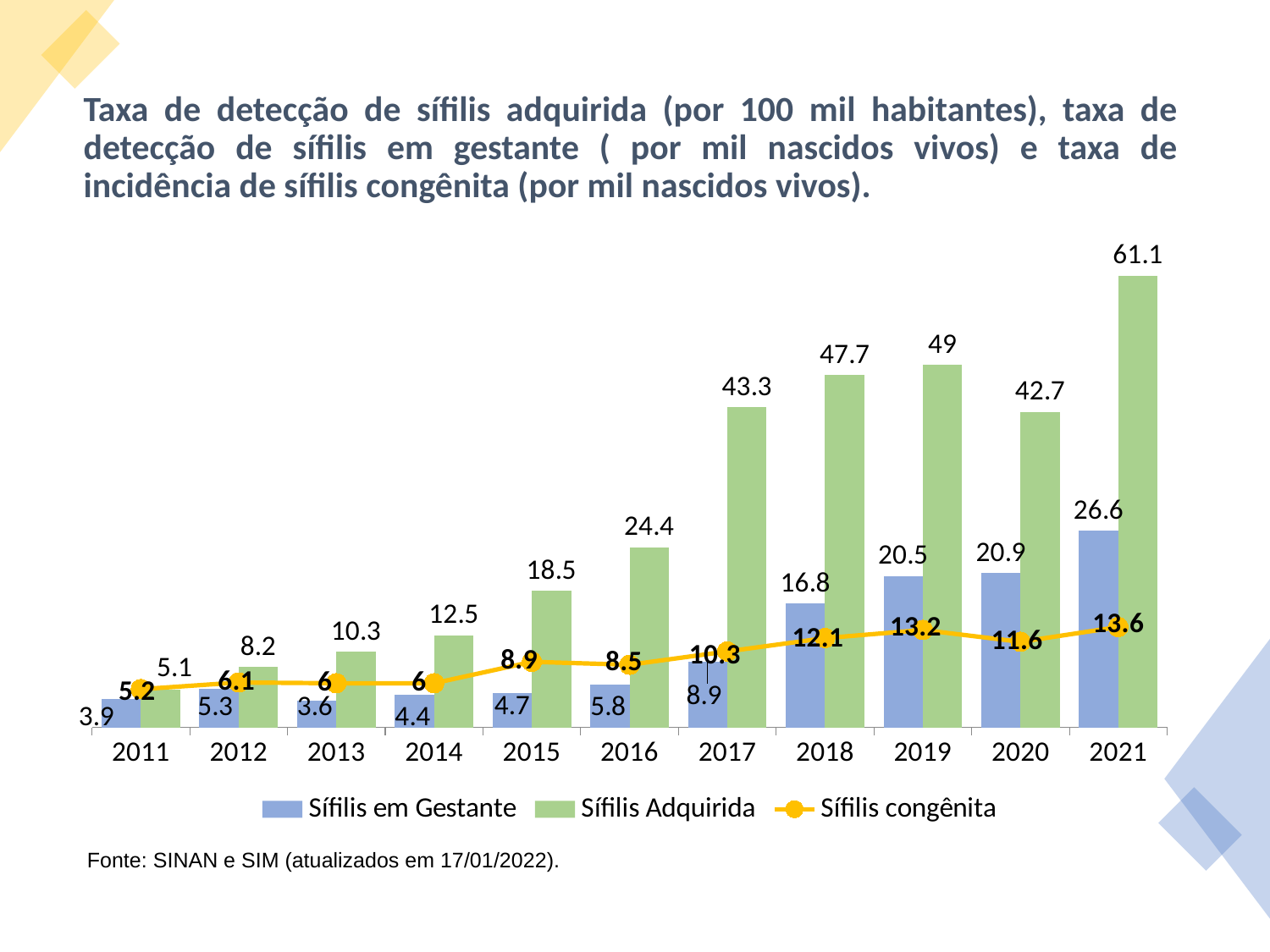
What is the value of Sífilis congênita in 2019? 13.2 What is the value of Sífilis Adquirida in 2021? 61.1 What is the value of Sífilis em Gestante in 2018? 16.8 What kind of chart is shown on the slide? Combined bar and line chart Which is larger in 2017: Sífilis Adquirida or Sífilis em Gestante? Sífilis Adquirida What is the difference between Sífilis Adquirida in 2021 and in 2020? 18.4 Does Sífilis em Gestante rise or fall from 2016 to 2021? Rise Which series is plotted as a line with markers? Sífilis congênita How many series does the legend list? 3 In which year is Sífilis Adquirida highest? 2021 How many years are shown on the x axis? 11 In which year is Sífilis em Gestante lowest? 2013